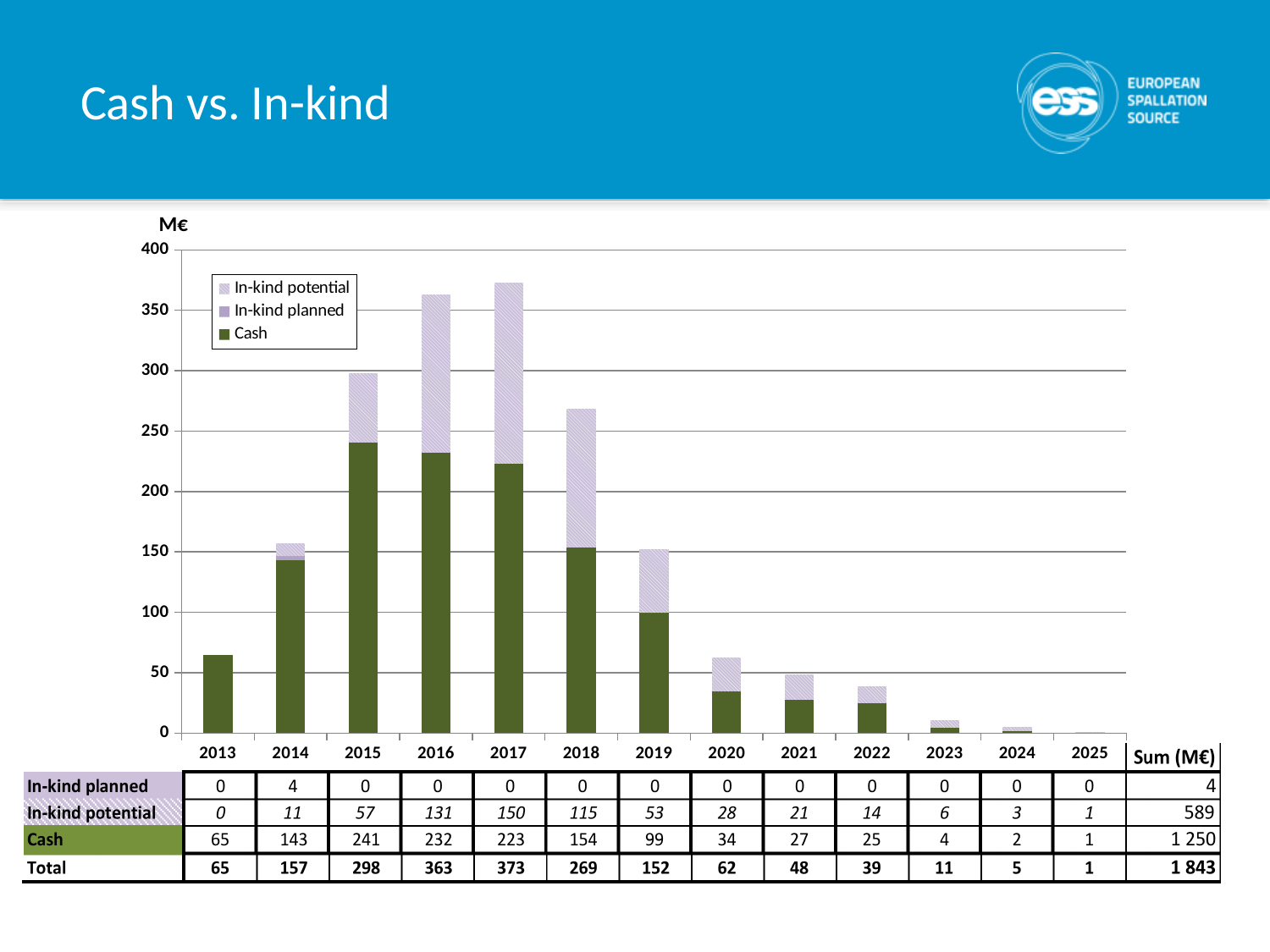
What is the In-kind planned value for 2014? 4 What is the sum (M€) of Cash across all years? 1 250 Which year has the highest total? 2017 Which year has the lowest total? 2025 What is the total of the stacked bar for 2016? 363 What is the difference between the Cash values for 2015 and 2016? 9 How many years are shown on the x axis? 13 What is the In-kind potential value for 2017? 150 What kind of chart is shown on the slide? stacked bar chart What is the Cash value for 2015? 241 Which is larger, the Cash value for 2018 or the Cash value for 2019? 2018 How many series does the legend list? 3